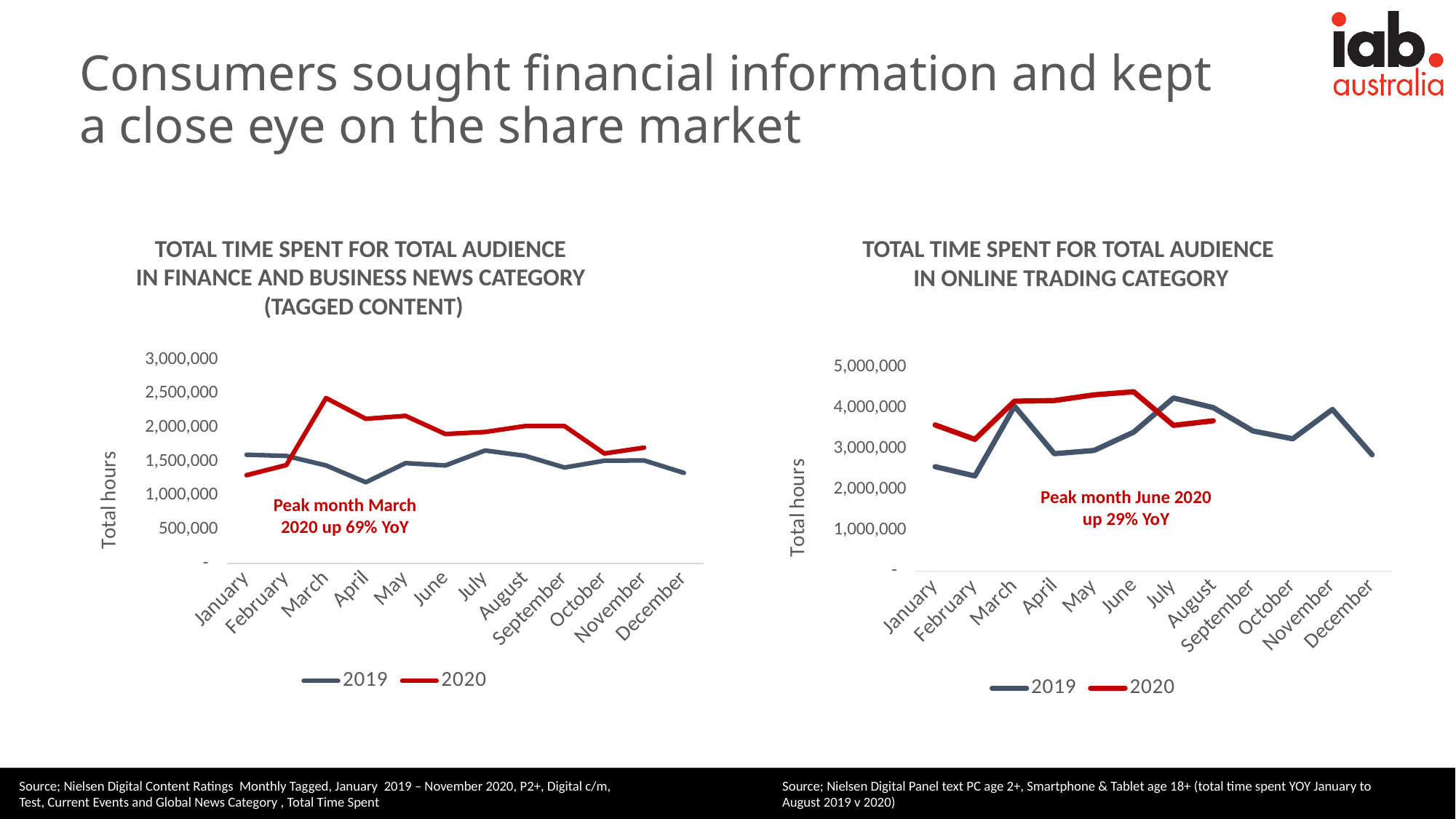
In the finance and business news chart on the left, which month has the highest value for the 2020 series? March According to the annotation on the online trading chart on the right, by what percentage was the peak month June 2020 up year on year? 29% In the online trading chart on the right, is the 2020 value for June greater or less than 4,000,000? greater In the finance and business news chart on the left, is the 2019 value for April greater or less than 1,500,000? less In the 'Total time spent for total audience in online trading category' chart on the right, how many series does the legend list? 2 In the finance and business news chart on the left, does the 2020 series rise or fall from March to April? Fall In the online trading chart on the right, is the 2019 value for February greater or less than 3,000,000? less In the online trading chart on the right, which month has the highest value for the 2020 series? June In the online trading chart on the right, which series has the larger value in July, 2019 or 2020? 2019 In the finance and business news chart on the left, how many months are shown on the x axis? 12 What kind of chart is the 'Total time spent for total audience in finance and business news category' chart on the left? Line chart